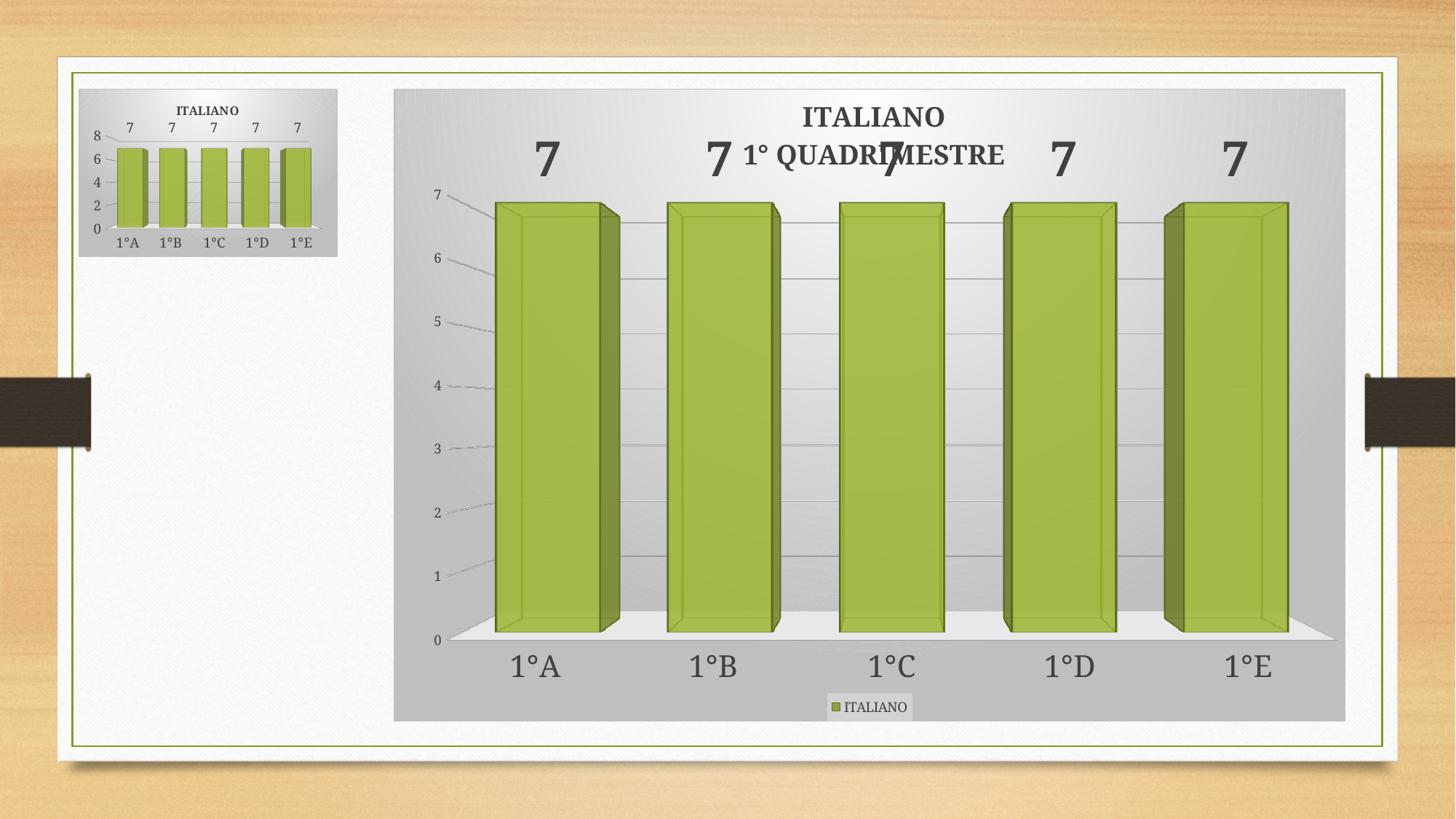
In the large chart titled 'ITALIANO 1° QUADRIMESTRE', how many categories are shown on the x axis? 5 In the large chart titled 'ITALIANO 1° QUADRIMESTRE', how many series does the legend list? 1 In the small chart at the top left titled 'ITALIANO', how many bars are plotted? 5 What kind of chart is the large chart titled 'ITALIANO 1° QUADRIMESTRE'? Bar chart In the large chart titled 'ITALIANO 1° QUADRIMESTRE', what is the difference between the values for 1°A and 1°D? 0 In the large chart titled 'ITALIANO 1° QUADRIMESTRE', do the values rise, fall or stay the same from 1°A to 1°E? Stay the same In the large chart titled 'ITALIANO 1° QUADRIMESTRE', what is the value for 1°C? 7 In the large chart titled 'ITALIANO 1° QUADRIMESTRE', is the value for 1°B greater or less than 5? greater What is the name of the series listed in the legend of the large chart titled 'ITALIANO 1° QUADRIMESTRE'? ITALIANO In the small chart at the top left titled 'ITALIANO', what is the value for 1°B? 7 In the large chart titled 'ITALIANO 1° QUADRIMESTRE', what is the value for 1°E? 7 What is the title of the small chart at the top left of the slide? ITALIANO